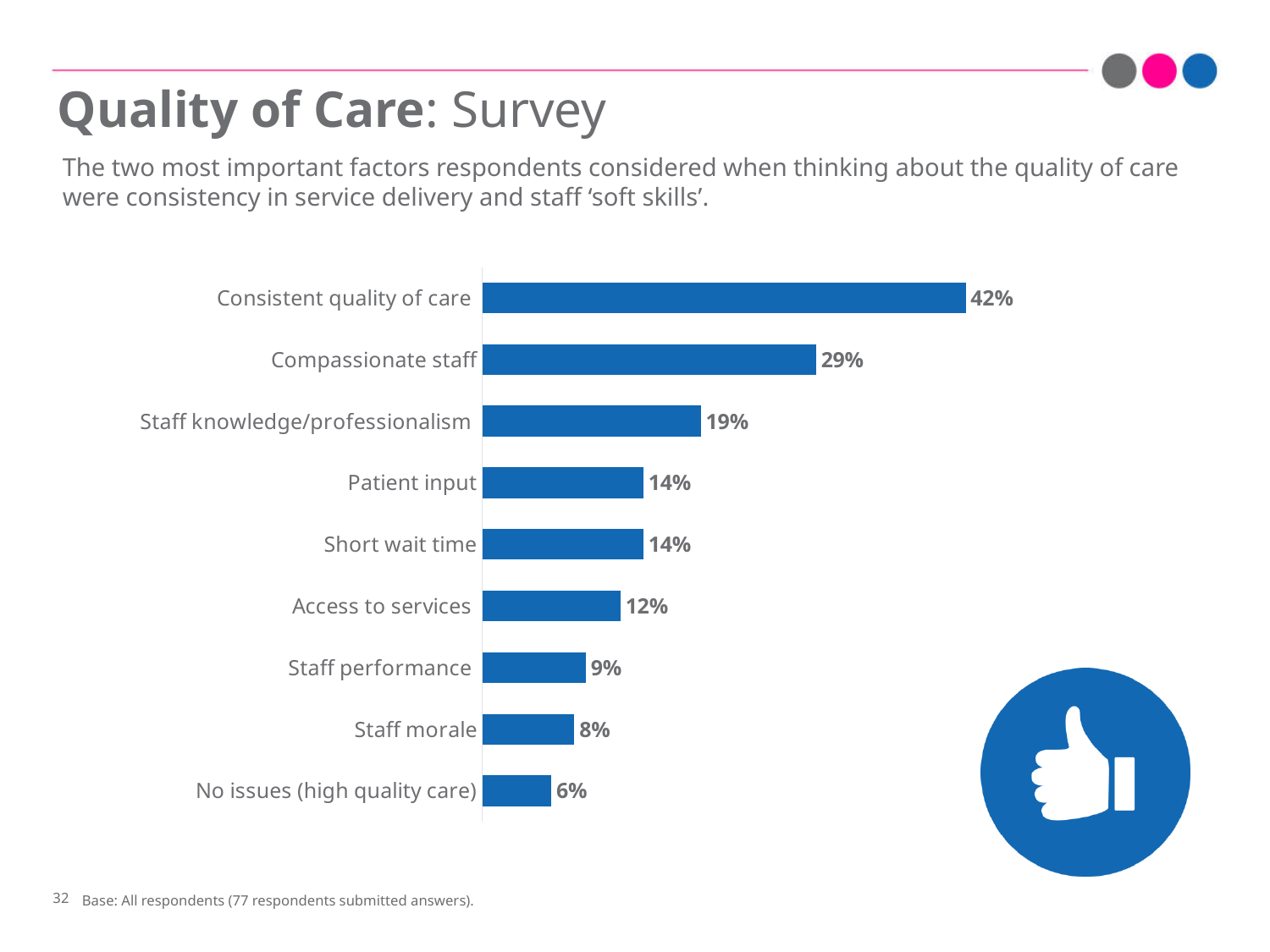
What is the value for Compassionate staff? 29% What is the difference between Access to services and Staff performance? 3% Which two categories share the same value of 14%? Patient input and Short wait time How many categories are shown in the chart? 9 What is the value for Staff morale? 8% What percentage is shown for Staff knowledge/professionalism? 19% Which is larger, Staff knowledge/professionalism or Patient input? Staff knowledge/professionalism What kind of chart is shown on the slide? Bar chart Which category has the highest value? Consistent quality of care Which category has the lowest value? No issues (high quality care) What is the difference between Consistent quality of care and Compassionate staff? 13% What percentage of respondents cited consistent quality of care? 42%